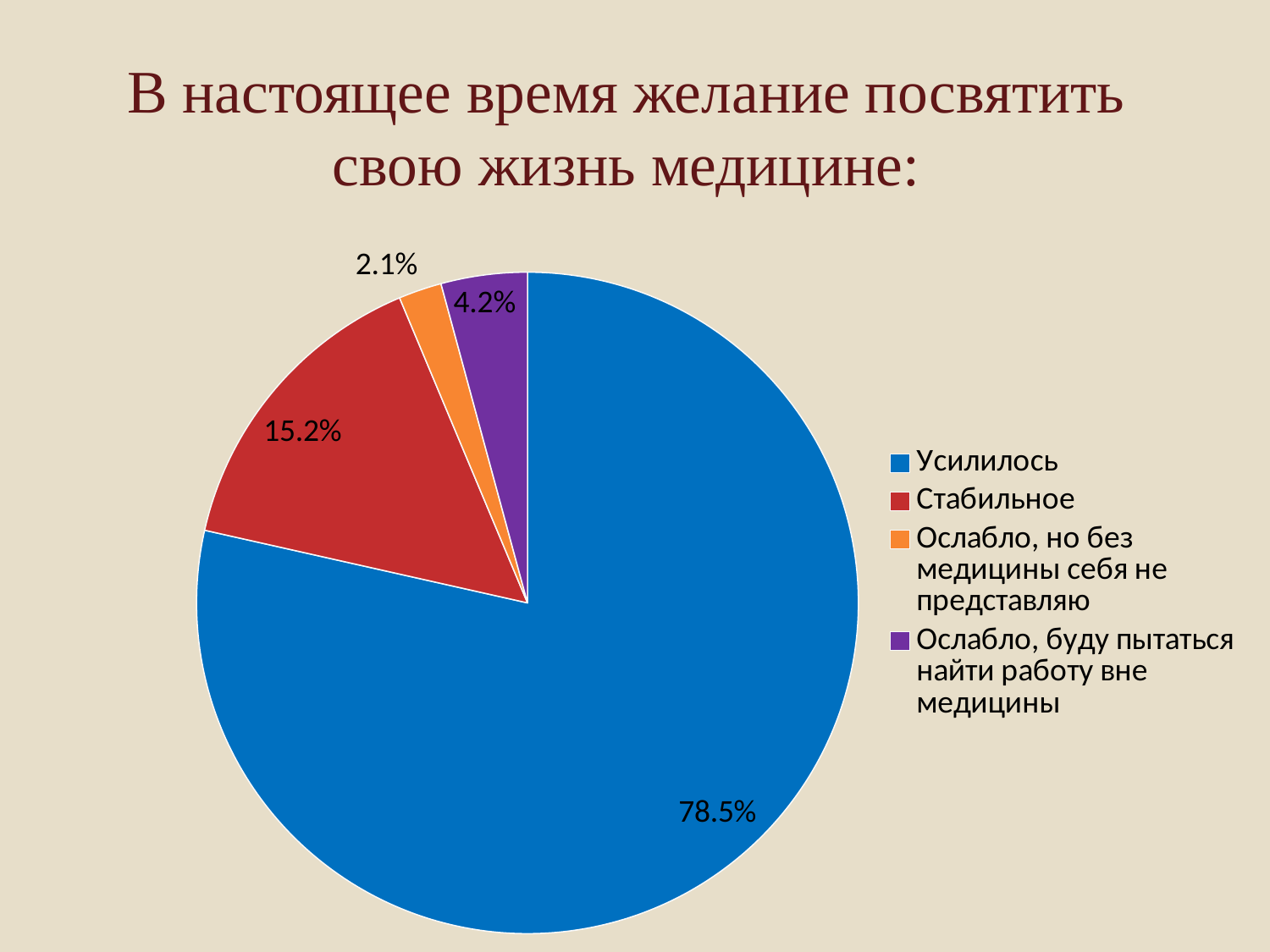
What colour is the slice for "Стабильное"? red What is the difference between the shares for "Ослабло, буду пытаться найти работу вне медицины" and "Ослабло, но без медицины себя не представляю"? 2.1% Which category has the smallest slice of the pie? Ослабло, но без медицины себя не представляю Which category has the largest slice of the pie? Усилилось What share of the pie does "Ослабло, буду пытаться найти работу вне медицины" have? 4.2% What type of chart is shown on the slide? pie chart How many categories does the legend list? 4 Which is larger: the share for "Стабильное" or the share for "Ослабло, буду пытаться найти работу вне медицины"? Стабильное What share of the pie does "Стабильное" have? 15.2% What share of the pie does "Усилилось" have? 78.5% What share of the pie does "Ослабло, но без медицины себя не представляю" have? 2.1% What is the difference between the shares for "Усилилось" and "Стабильное"? 63.3%